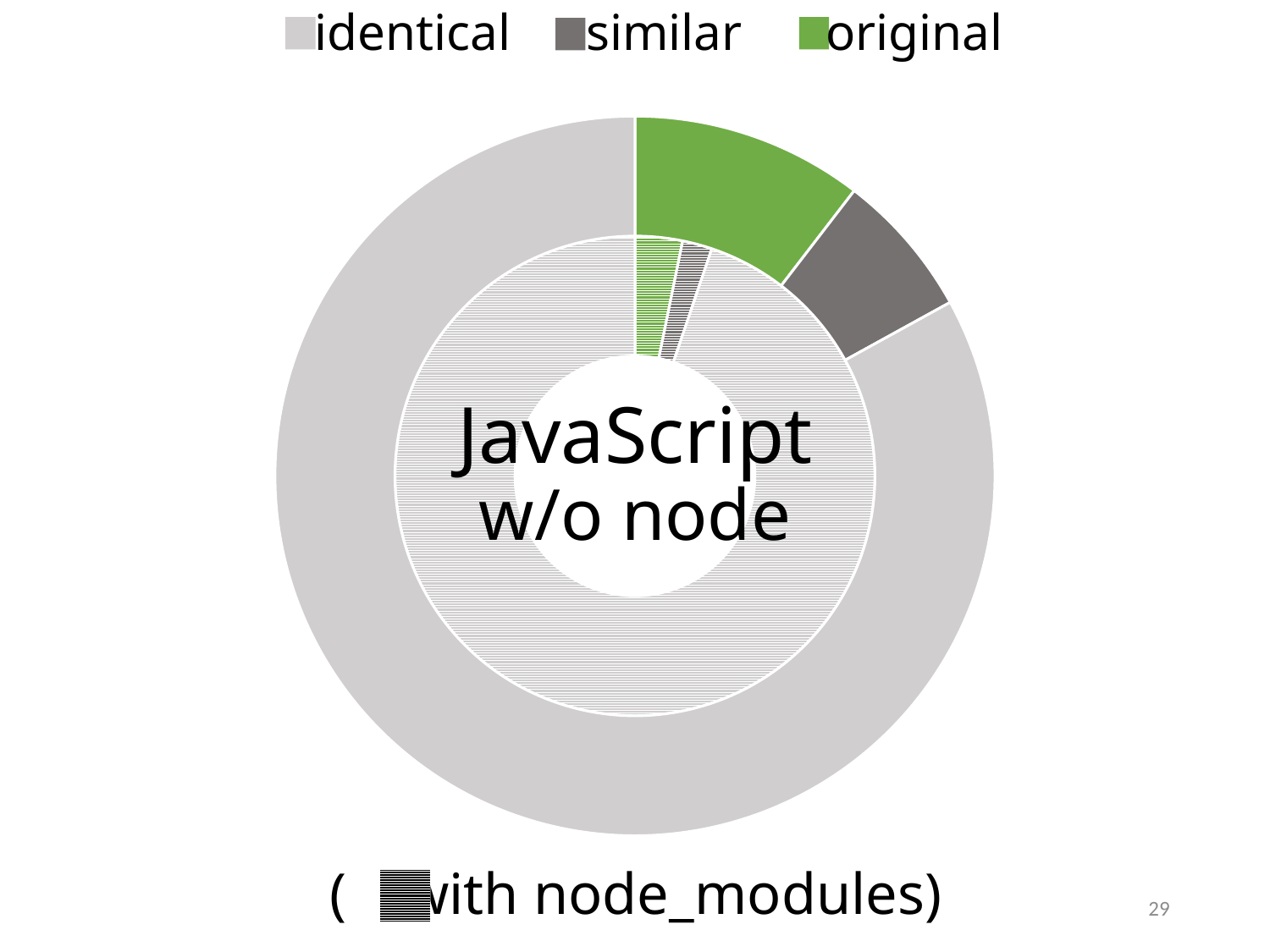
What kind of chart is shown on the slide? doughnut chart Which category takes up the largest share of the inner ring (with node_modules)? identical Which category takes up the largest share of the outer ring (JavaScript w/o node)? identical Which category takes up the smallest share of the outer ring (JavaScript w/o node)? similar In the outer ring, which is larger: the share for identical or the share for original? identical What text is written in the centre of the chart? JavaScript w/o node Which colour represents the original category in the legend? green Which category takes up the smallest share of the inner ring (with node_modules)? similar How many rings does the doughnut chart have? 2 Which ring has the larger share for original: the outer ring (w/o node) or the inner ring (with node_modules)? outer ring (w/o node) How many categories does the legend list? 3 In the outer ring, which is larger: the share for original or the share for similar? original